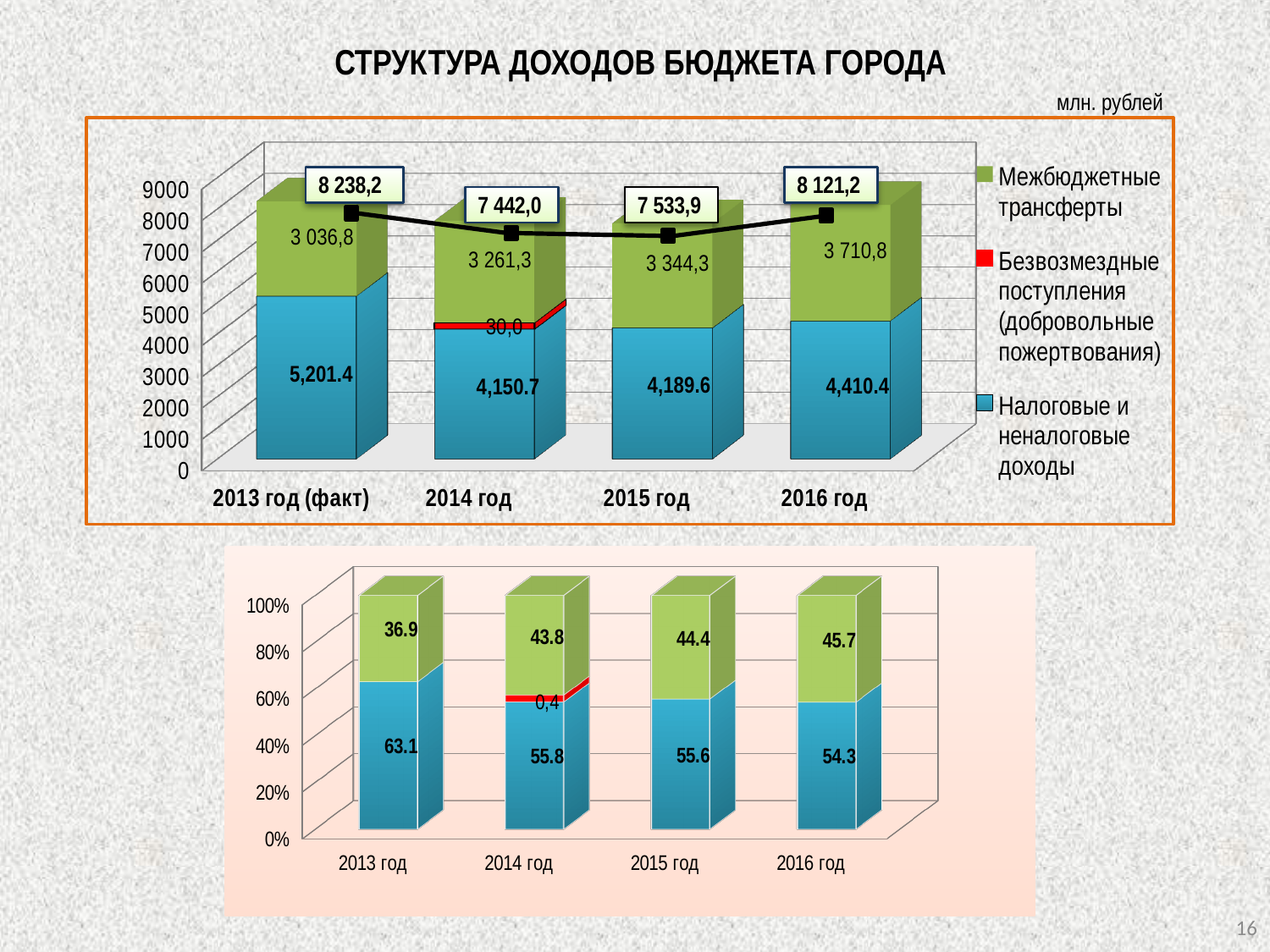
How many series does the legend of the top chart list? 3 In the top chart, which year has the highest value of Межбюджетные трансферты? 2016 год In the top chart, which year has the lowest value of Налоговые и неналоговые доходы? 2014 год In the top chart, what is the value of Налоговые и неналоговые доходы for 2013 год (факт)? 5,201.4 In the top chart, what total is shown above the bar for 2014 год? 7 442,0 In the top chart, what is the value of Безвозмездные поступления (добровольные пожертвования) for 2014 год? 30,0 In the top chart, what is the difference between the Налоговые и неналоговые доходы values for 2013 год (факт) and 2016 год? 791.0 In the bottom chart, does the blue segment's value rise or fall from 2013 год to 2016 год? fall In the top chart, what is the value of Межбюджетные трансферты for 2016 год? 3 710,8 In the bottom chart, what is the share of the green segment for 2015 год? 44.4 In the bottom chart, which year has the highest value for the blue segment? 2013 год In the top chart, is the total for 2015 год larger or smaller than the total for 2013 год (факт)? smaller